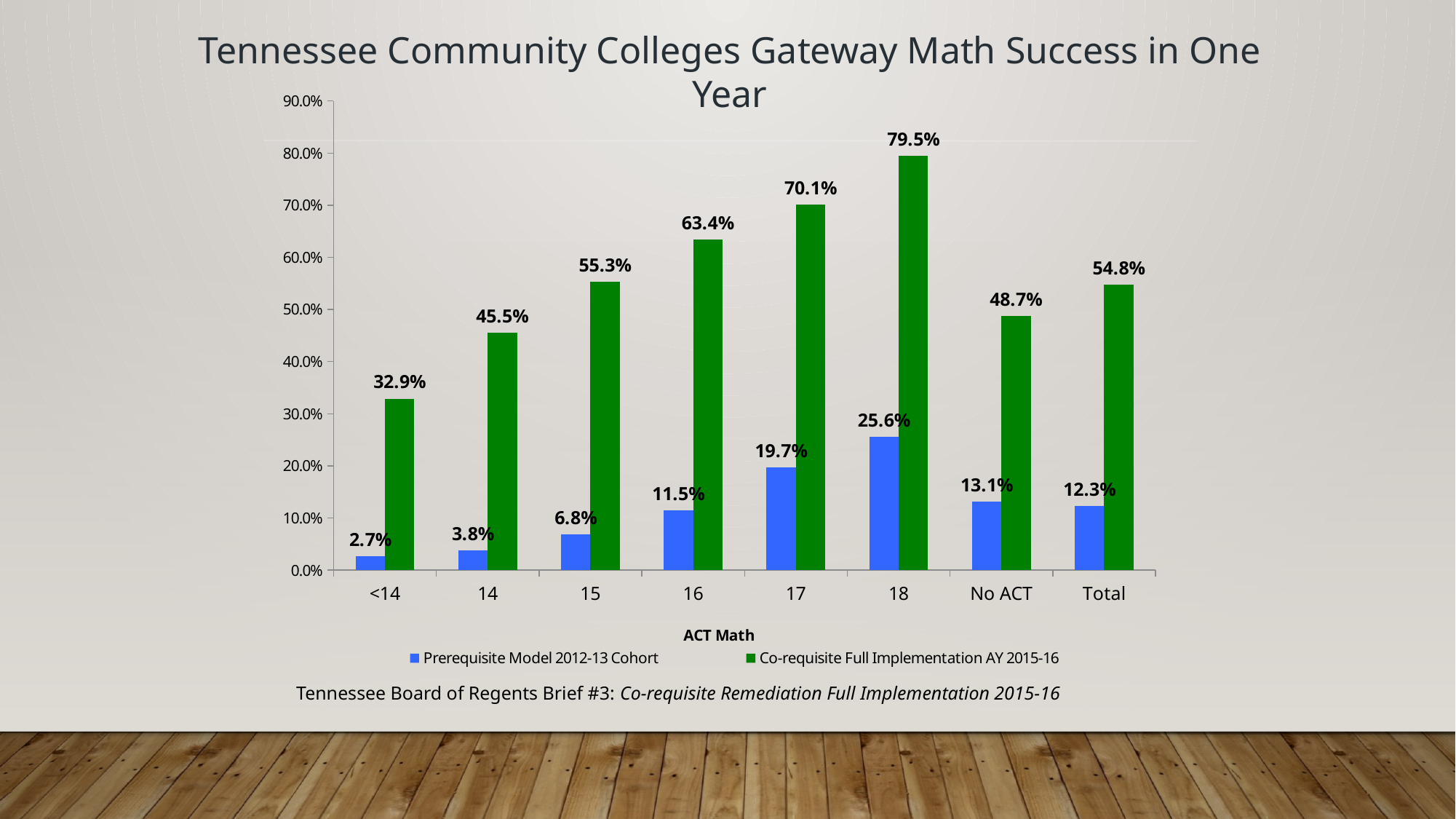
What is the difference between the Co-requisite and Prerequisite values for the Total category? 42.5% Which is larger for the No ACT category: the Prerequisite Model 2012-13 Cohort value or the Co-requisite Full Implementation AY 2015-16 value? Co-requisite Full Implementation AY 2015-16 How many series does the legend list? 2 How many categories are shown on the x axis? 8 Do the Co-requisite Full Implementation AY 2015-16 values rise or fall from ACT Math score <14 to 18? rise Is the Co-requisite Full Implementation AY 2015-16 value for ACT Math score 15 greater or less than 50.0%? greater What kind of chart is shown on the slide? bar chart What is the Co-requisite Full Implementation AY 2015-16 value for ACT Math score 18? 79.5% Which ACT Math category has the highest Co-requisite Full Implementation AY 2015-16 value? 18 Which ACT Math category has the lowest Prerequisite Model 2012-13 Cohort value? <14 What is the Prerequisite Model 2012-13 Cohort value for the Total category? 12.3% What is the Prerequisite Model 2012-13 Cohort value for ACT Math score 16? 11.5%